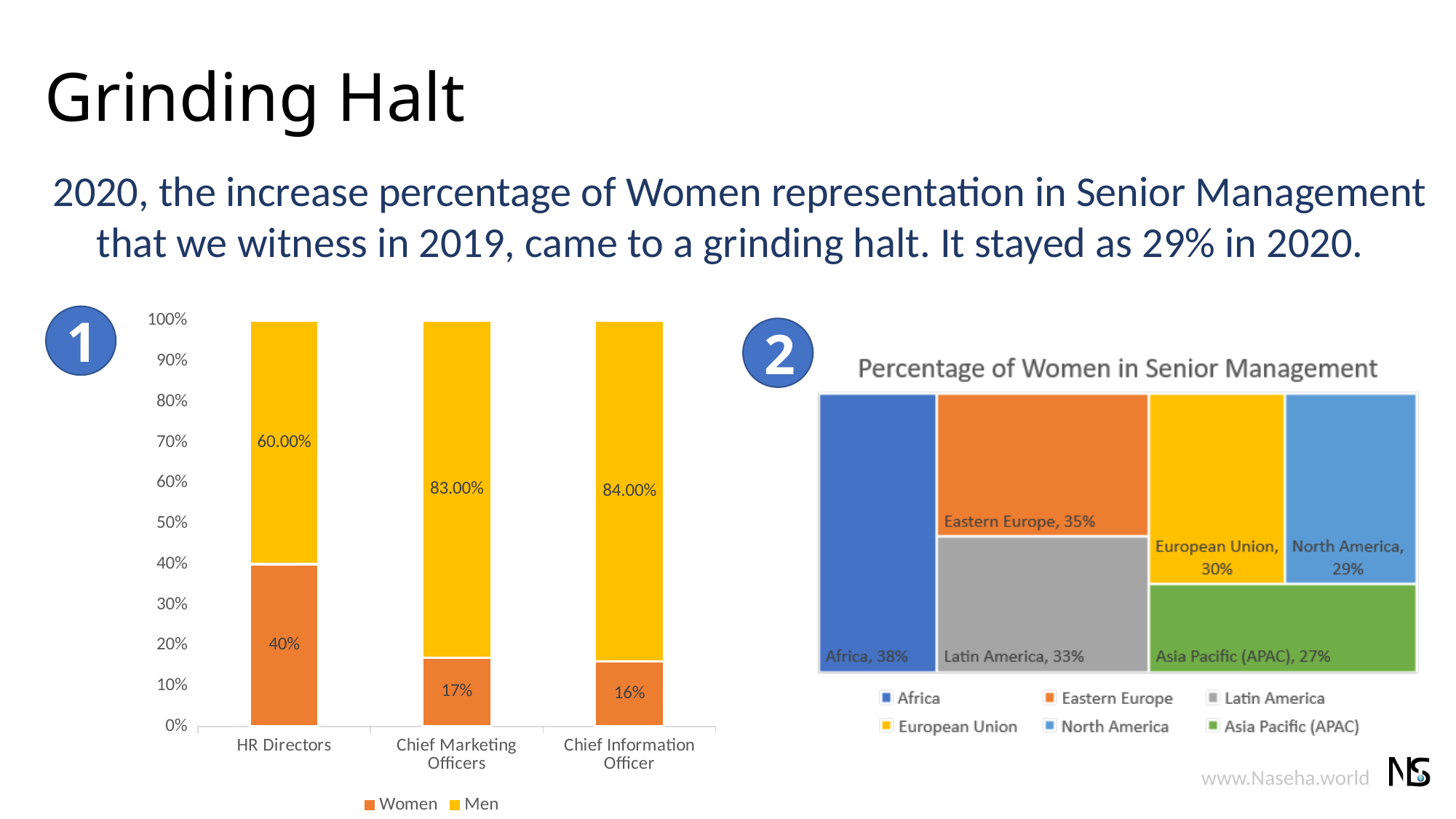
In the left stacked bar chart (chart 1), what is the value for Women among Chief Information Officer? 16% What kind of chart is chart 1 on the left of the slide? Stacked bar chart In the left stacked bar chart (chart 1), how many series does the legend list? 2 In the 'Percentage of Women in Senior Management' chart (chart 2), which is larger, Eastern Europe or European Union? Eastern Europe In the left stacked bar chart (chart 1), what is the value for Men among Chief Marketing Officers? 83.00% In the 'Percentage of Women in Senior Management' chart (chart 2), what is the value for Latin America? 33% In the left stacked bar chart (chart 1), what is the difference between the Men value for Chief Information Officer and the Men value for HR Directors? 24.00% In the left stacked bar chart (chart 1), how many categories are shown on the x axis? 3 In the left stacked bar chart (chart 1), what is the value for Women among HR Directors? 40% In the 'Percentage of Women in Senior Management' chart (chart 2), which region has the lowest value? Asia Pacific (APAC) In the left stacked bar chart (chart 1), which category has the highest value for Women? HR Directors In the 'Percentage of Women in Senior Management' chart (chart 2), how many regions does the legend list? 6